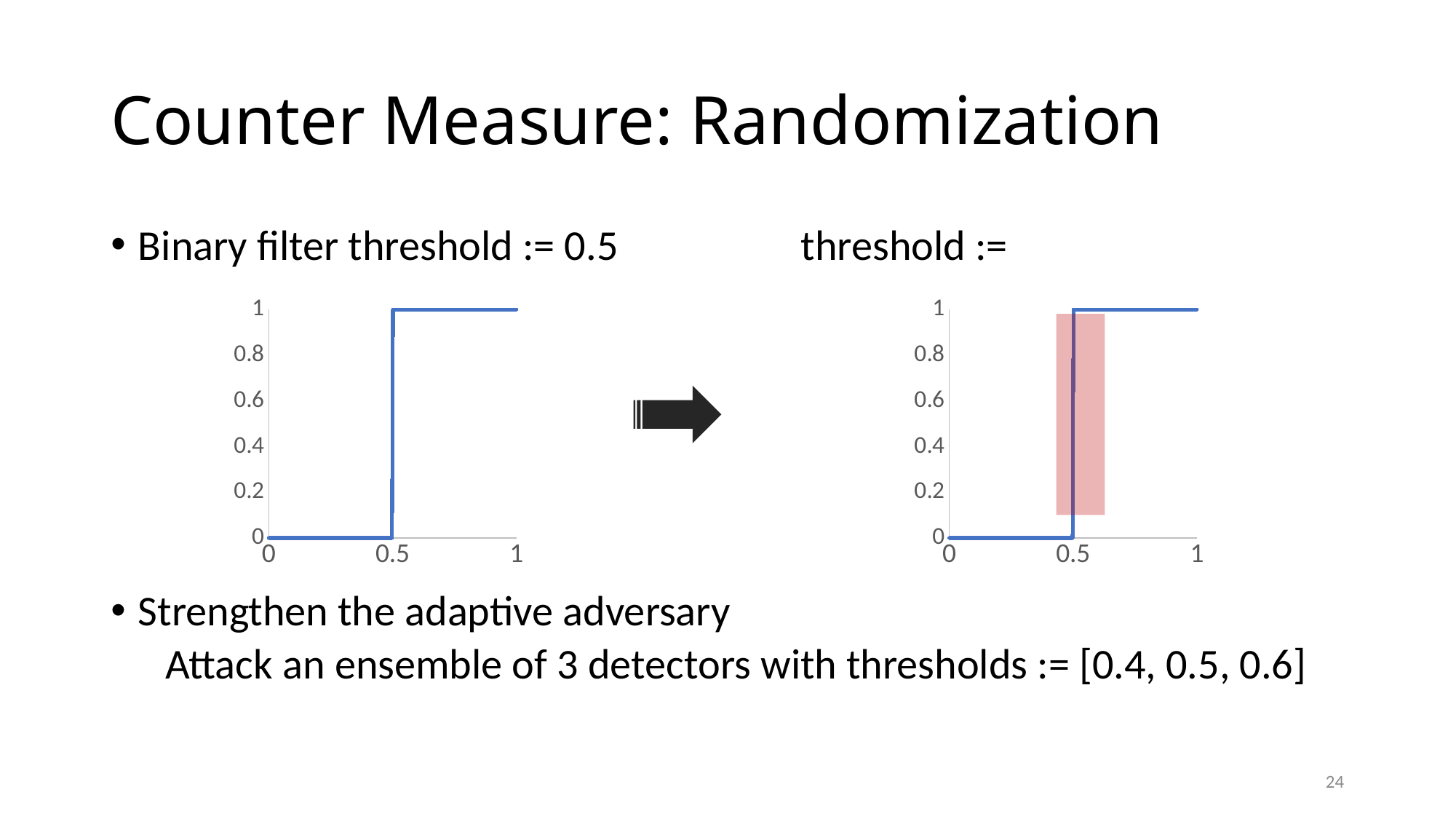
What is the highest tick label on the y axis of the left chart? 1 How many tick labels are shown on the x axis of the right chart? 3 In the left chart, is the value of the line at x = 0.25 greater or less than 0.2? less In the left chart, does the line rise or fall as x increases from 0 to 1? rise In the right chart, what is the value of the line at x = 1? 1 What kind of chart is the left chart on the slide? line chart In the left chart, what is the value of the line at x = 1? 1 In the left chart, what is the value of the line at x = 0? 0 In the left chart, at what x value does the line jump from 0 to 1? 0.5 In the right chart, is the value of the line at x = 0.75 greater or less than 0.8? greater In the right chart, what colour is the shaded band around x = 0.5? pink How many charts are shown on the slide? 2